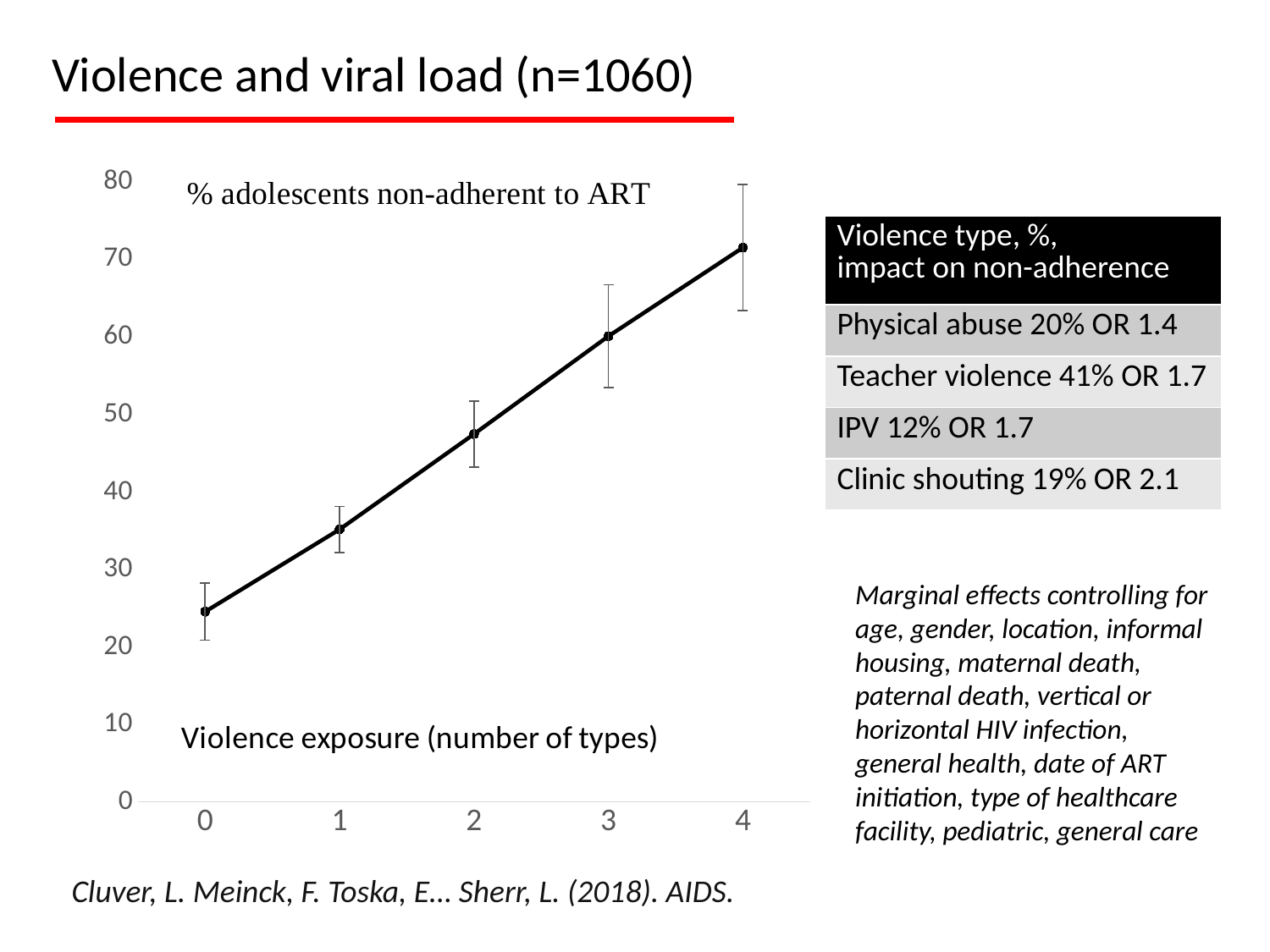
Does the percentage of adolescents non-adherent to ART rise or fall as violence exposure increases from 0 to 4 types? rise Is the value for violence exposure 2 greater or less than 40? greater Which has a higher percentage of adolescents non-adherent to ART: violence exposure 1 or violence exposure 3? 3 Is the value for violence exposure 0 greater or less than 30? less Is the value for violence exposure 1 greater or less than 40? less How many violence exposure categories are plotted along the x axis? 5 What kind of chart is shown on the slide? line chart What does the y axis of the chart measure? % adolescents non-adherent to ART Which violence exposure level has the lowest percentage of adolescents non-adherent to ART? 0 Which violence exposure level has the highest percentage of adolescents non-adherent to ART? 4 What is the label of the x axis of the chart? Violence exposure (number of types)